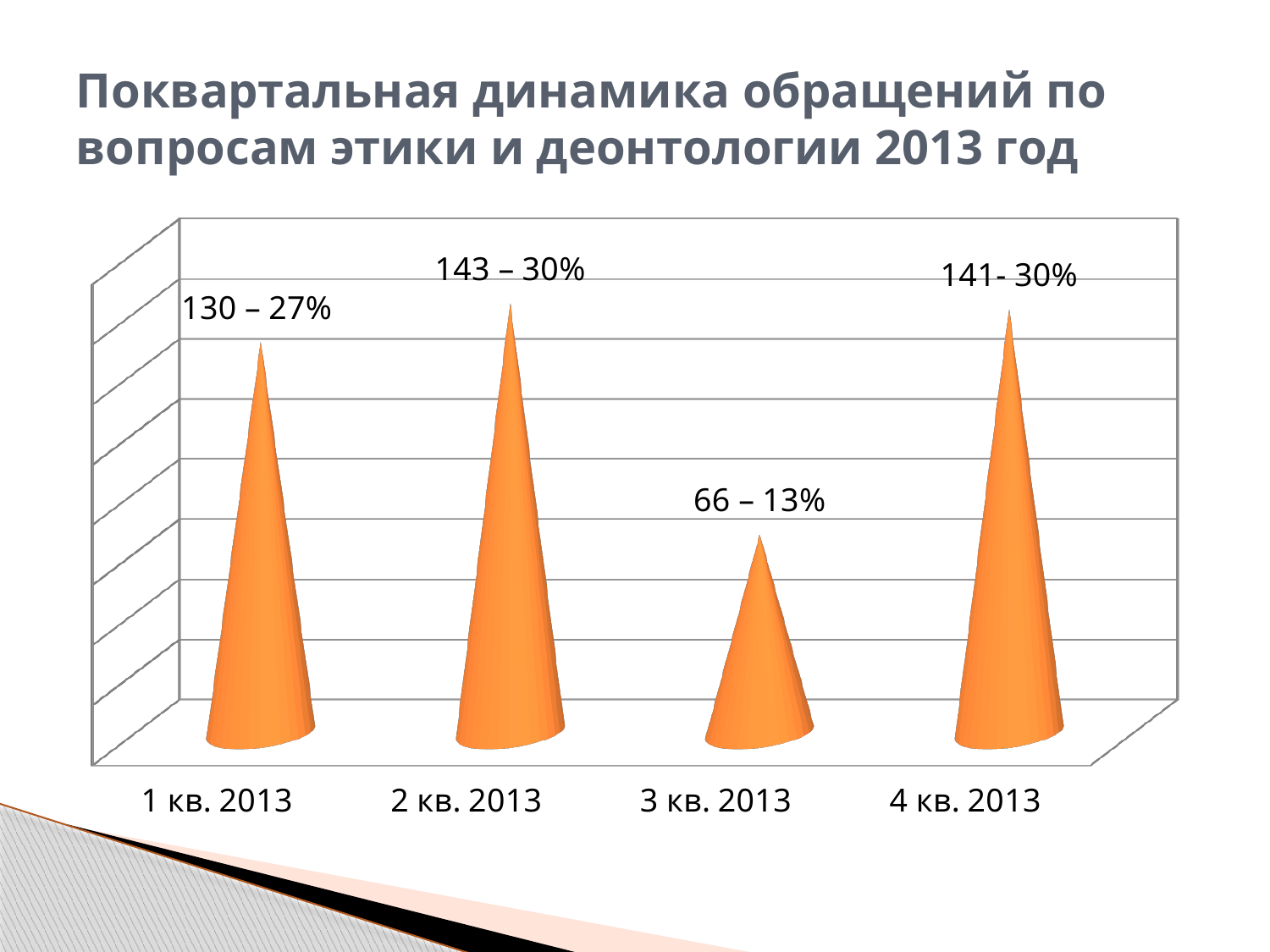
What is the data label shown for 1 кв. 2013? 130 – 27% Which is larger, the value for 1 кв. 2013 or the value for 3 кв. 2013? 1 кв. 2013 How many quarters are plotted on the chart? 4 What is the difference between the values for 1 кв. 2013 (130) and 3 кв. 2013 (66)? 64 Which quarter has the lowest value? 3 кв. 2013 What is the data label shown for 2 кв. 2013? 143 – 30% What percentage is shown for 4 кв. 2013? 30% Which quarter has the highest value? 2 кв. 2013 What is the difference between the values for 2 кв. 2013 (143) and 3 кв. 2013 (66)? 77 Does the value rise or fall from 2 кв. 2013 to 3 кв. 2013? Fall What is the data label shown for 3 кв. 2013? 66 – 13% What kind of chart is shown on the slide? Bar chart